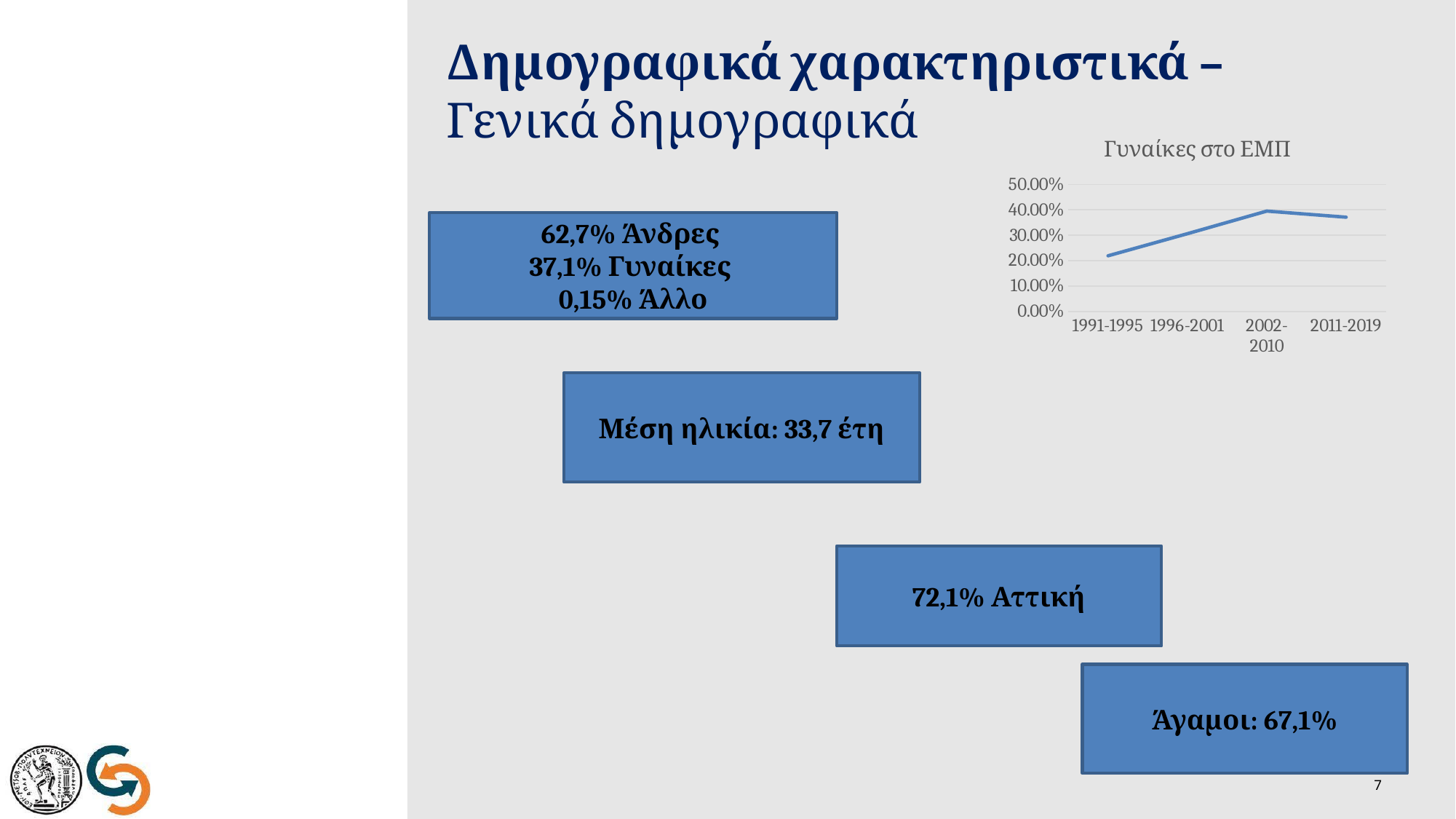
How many period categories are shown on the x axis of the "Γυναίκες στο ΕΜΠ" chart? 4 In the "Γυναίκες στο ΕΜΠ" chart, does the line rise or fall from 1991-1995 to 2002-2010? rise What kind of chart is shown under the title "Γυναίκες στο ΕΜΠ"? line chart In the "Γυναίκες στο ΕΜΠ" chart, is the value for 2002-2010 greater or less than 30.00%? greater In the "Γυναίκες στο ΕΜΠ" chart, which is larger: the value for 1991-1995 or the value for 2011-2019? 2011-2019 In the "Γυναίκες στο ΕΜΠ" chart, is the value for 2011-2019 greater or less than 40.00%? less In the "Γυναίκες στο ΕΜΠ" chart, which period has the highest value? 2002-2010 What is the highest value shown on the y axis of the "Γυναίκες στο ΕΜΠ" chart? 50.00% In the "Γυναίκες στο ΕΜΠ" chart, is the value for 1991-1995 greater or less than 30.00%? less What is the title of the chart on the slide? Γυναίκες στο ΕΜΠ In the "Γυναίκες στο ΕΜΠ" chart, which period has the lowest value? 1991-1995 How many lines (data series) are plotted in the "Γυναίκες στο ΕΜΠ" chart? 1